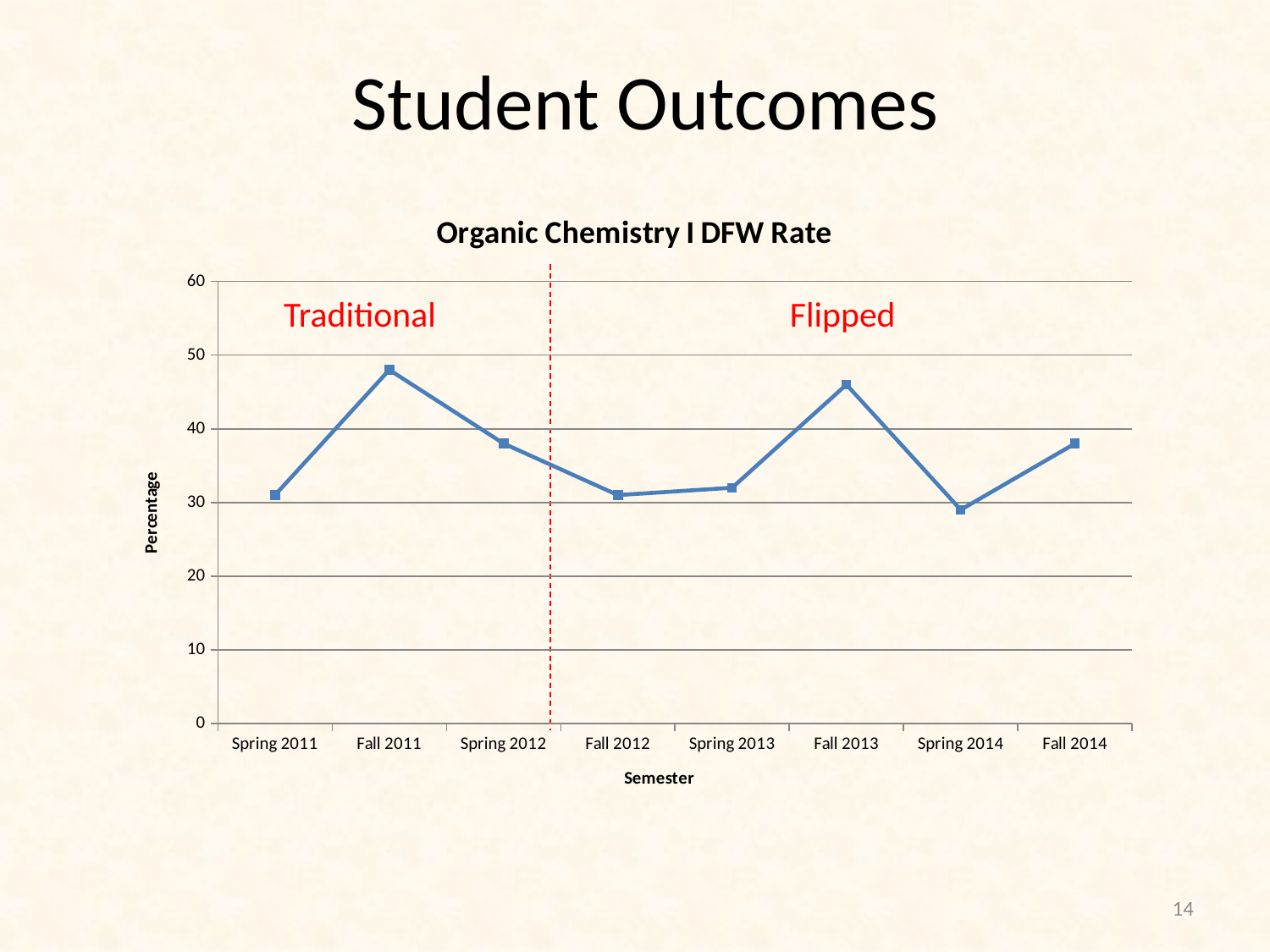
What kind of chart is shown on the slide? Line chart Which is larger, the value for Fall 2013 or the value for Spring 2014? Fall 2013 Is the value for Spring 2011 greater or less than 40? less What is the title of the chart? Organic Chemistry I DFW Rate Is the value for Fall 2011 greater or less than 40? greater How many semesters are plotted along the x axis? 8 Is the value for Fall 2014 greater or less than 40? less Does the DFW rate rise or fall from Fall 2013 to Spring 2014? Fall What is the label on the vertical axis of the chart? Percentage Which is larger, the value for Fall 2011 or the value for Spring 2011? Fall 2011